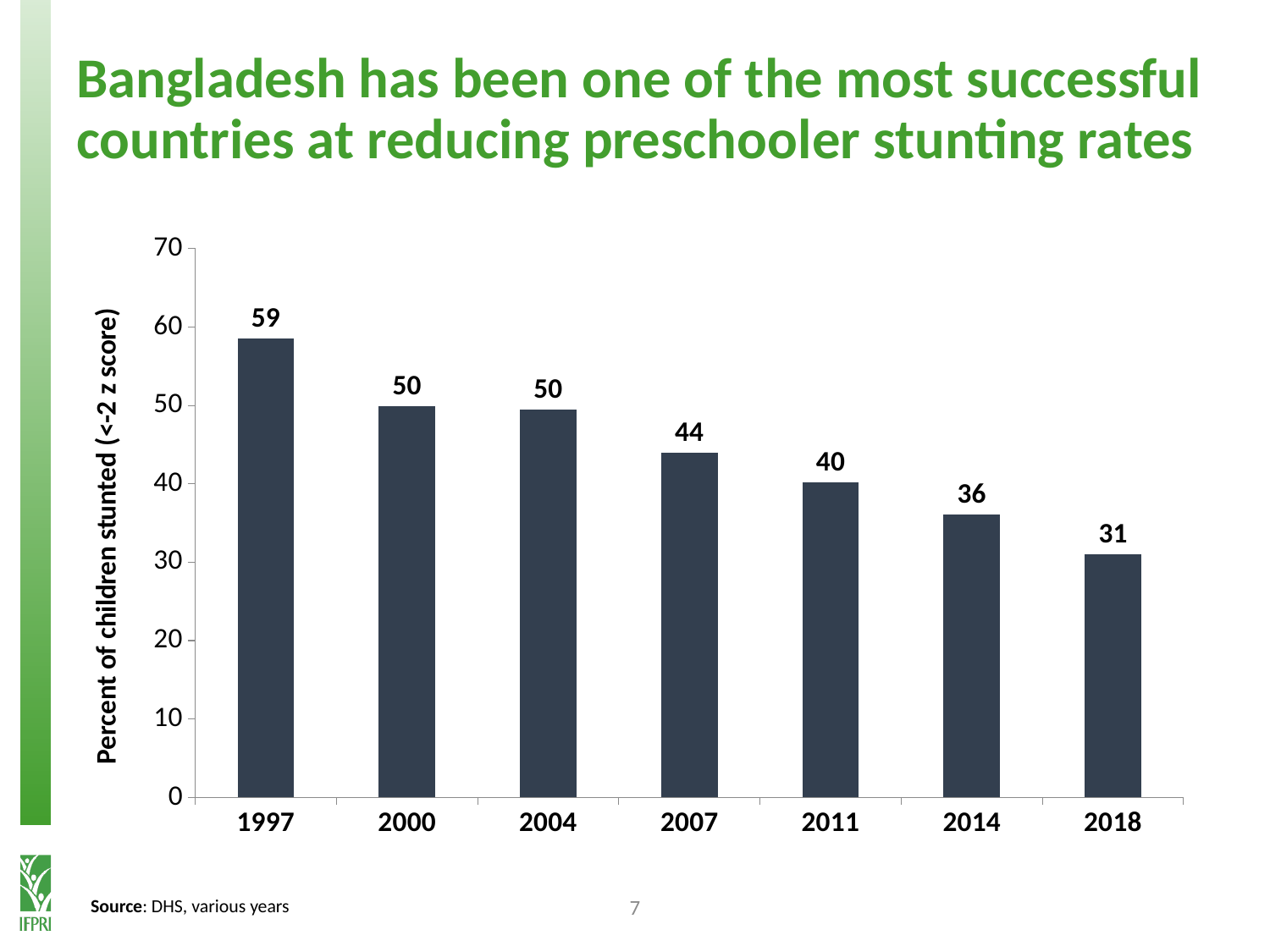
How many years are shown on the x axis? 7 Which year has the highest percent of children stunted? 1997 Do the stunting rates rise or fall from 1997 to 2018? fall Which year has the lowest percent of children stunted? 2018 What kind of chart is shown on the slide? bar chart What is the difference between the stunting rate in 1997 and in 2018? 28 Which year has a higher stunting rate, 2007 or 2014? 2007 What is the percent of children stunted in 1997? 59 What is the percent of children stunted in 2007? 44 Is the value for 2011 greater or less than 50? less What is the difference between the stunting rate in 2011 and in 2014? 4 What is the percent of children stunted in 2018? 31